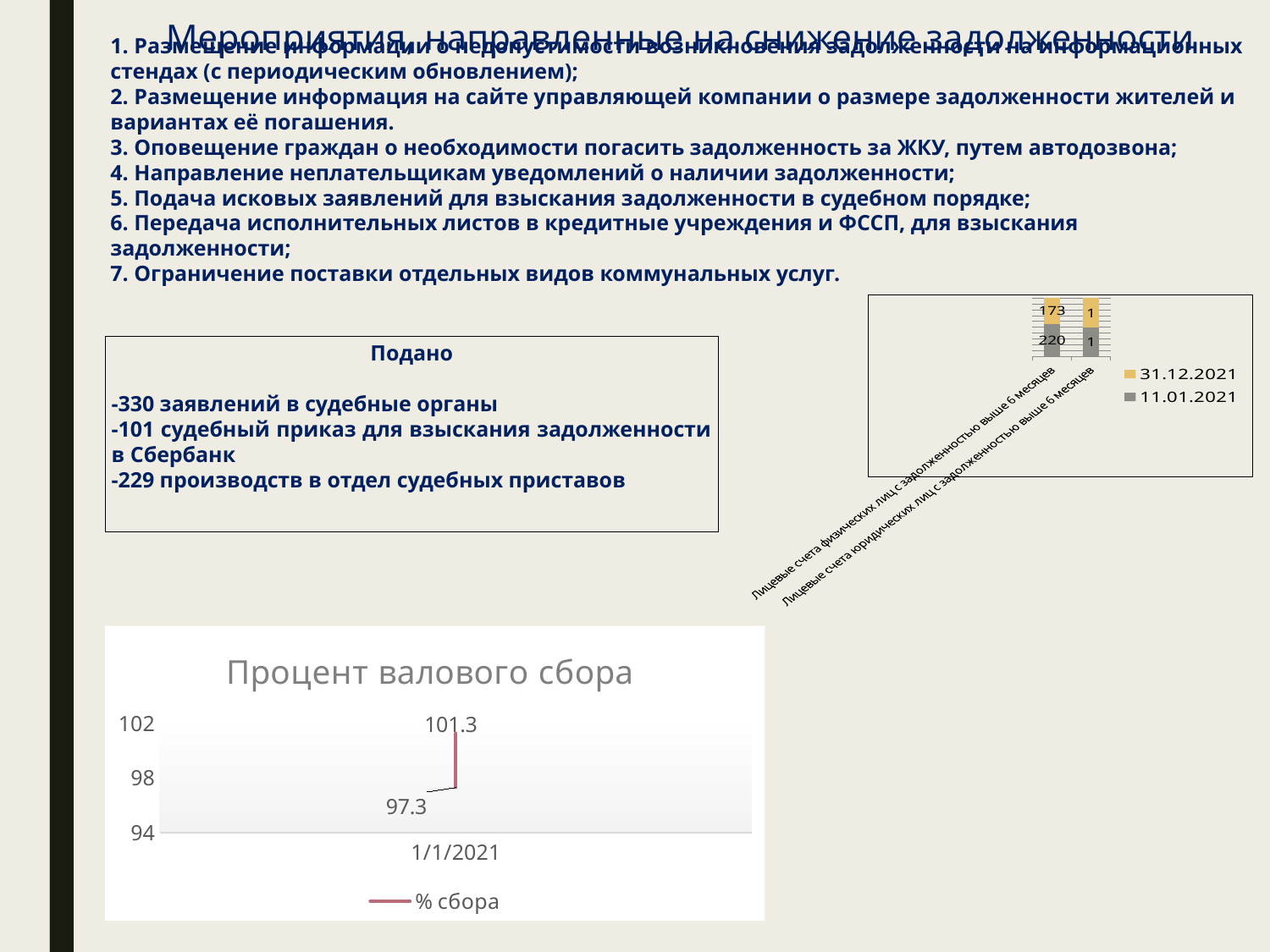
In the stacked bar chart at the top right of the slide, what is the total of the stacked bar for 'Лицевые счета физических лиц с задолженностью выше 6 месяцев'? 393 In the chart titled 'Процент валового сбора', what type of chart is shown? line chart In the chart titled 'Процент валового сбора', does the line rise or fall from left to right? rise In the stacked bar chart at the top right of the slide, how many series does the legend list? 2 In the chart titled 'Процент валового сбора', what series name does the legend show? % сбора In the chart titled 'Процент валового сбора', what is the lowest value printed on the line? 97.3 In the chart titled 'Процент валового сбора', what is the highest value printed on the line? 101.3 In the stacked bar chart at the top right of the slide, which series is larger for 'Лицевые счета физических лиц с задолженностью выше 6 месяцев': 31.12.2021 or 11.01.2021? 11.01.2021 In the chart titled 'Процент валового сбора', how many series does the legend list? 1 In the stacked bar chart at the top right of the slide, what is the value for 'Лицевые счета физических лиц с задолженностью выше 6 месяцев' in the 11.01.2021 series? 220 In the stacked bar chart at the top right of the slide, what is the value for 'Лицевые счета физических лиц с задолженностью выше 6 месяцев' in the 31.12.2021 series? 173 In the chart titled 'Процент валового сбора', what is the difference between the two printed values, 101.3 and 97.3? 4